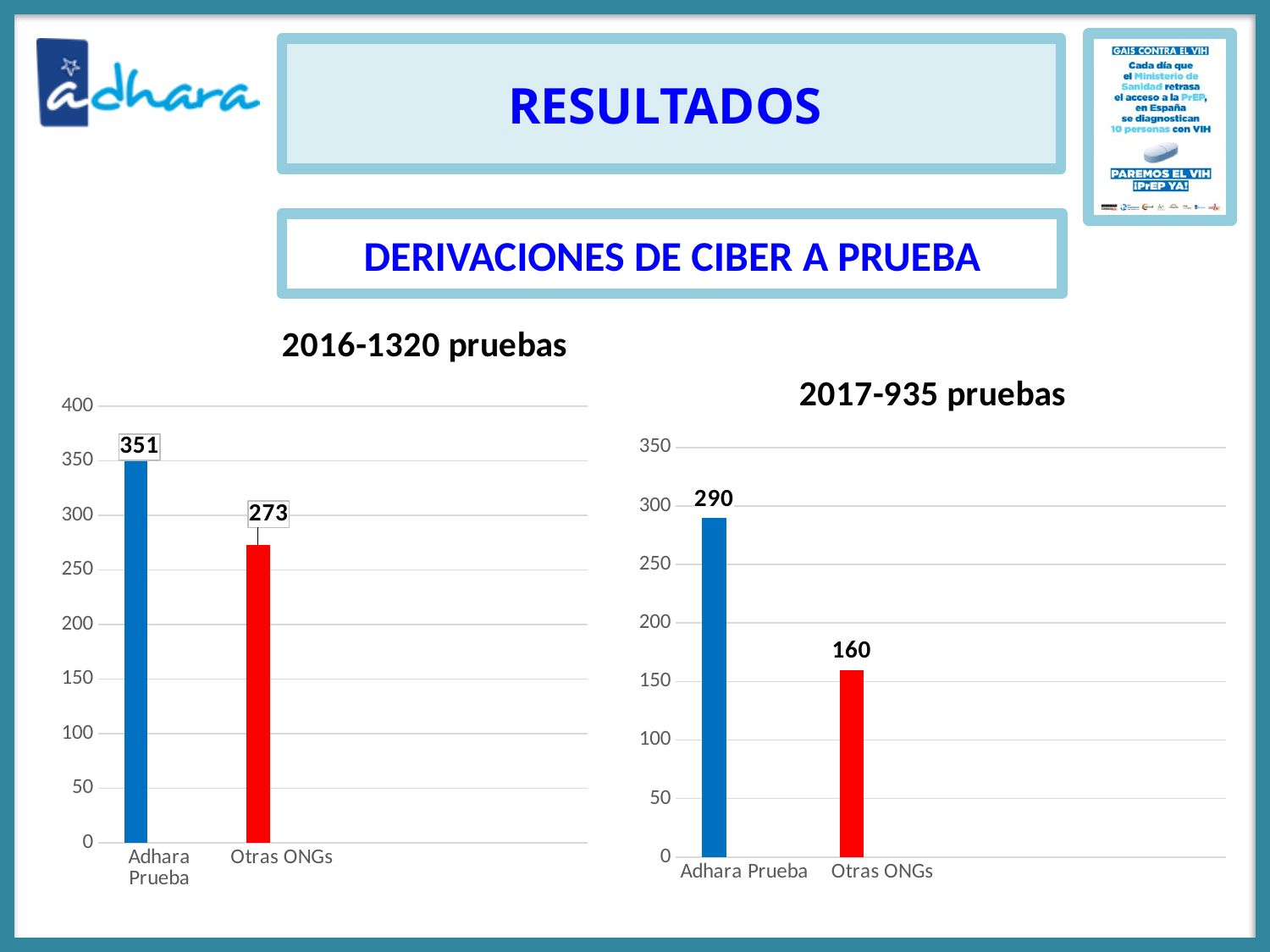
In the chart titled '2017-935 pruebas', which category has the lowest value? Otras ONGs In the chart titled '2017-935 pruebas', what is the value for Adhara Prueba? 290 In the chart titled '2016-1320 pruebas', which category has the highest value? Adhara Prueba In the chart titled '2016-1320 pruebas', what is the value for Otras ONGs? 273 In the chart titled '2017-935 pruebas', is the value for Otras ONGs greater or less than 200? less What kind of chart is the chart titled '2017-935 pruebas'? bar chart In the chart titled '2016-1320 pruebas', what colour is the bar for Otras ONGs? red In the chart titled '2016-1320 pruebas', what is the difference between the values for Adhara Prueba and Otras ONGs? 78 In the chart titled '2016-1320 pruebas', what is the value for Adhara Prueba? 351 In the chart titled '2017-935 pruebas', what is the value for Otras ONGs? 160 In the chart titled '2017-935 pruebas', what is the difference between the values for Adhara Prueba and Otras ONGs? 130 In the chart titled '2016-1320 pruebas', how many categories are shown on the x axis? 2